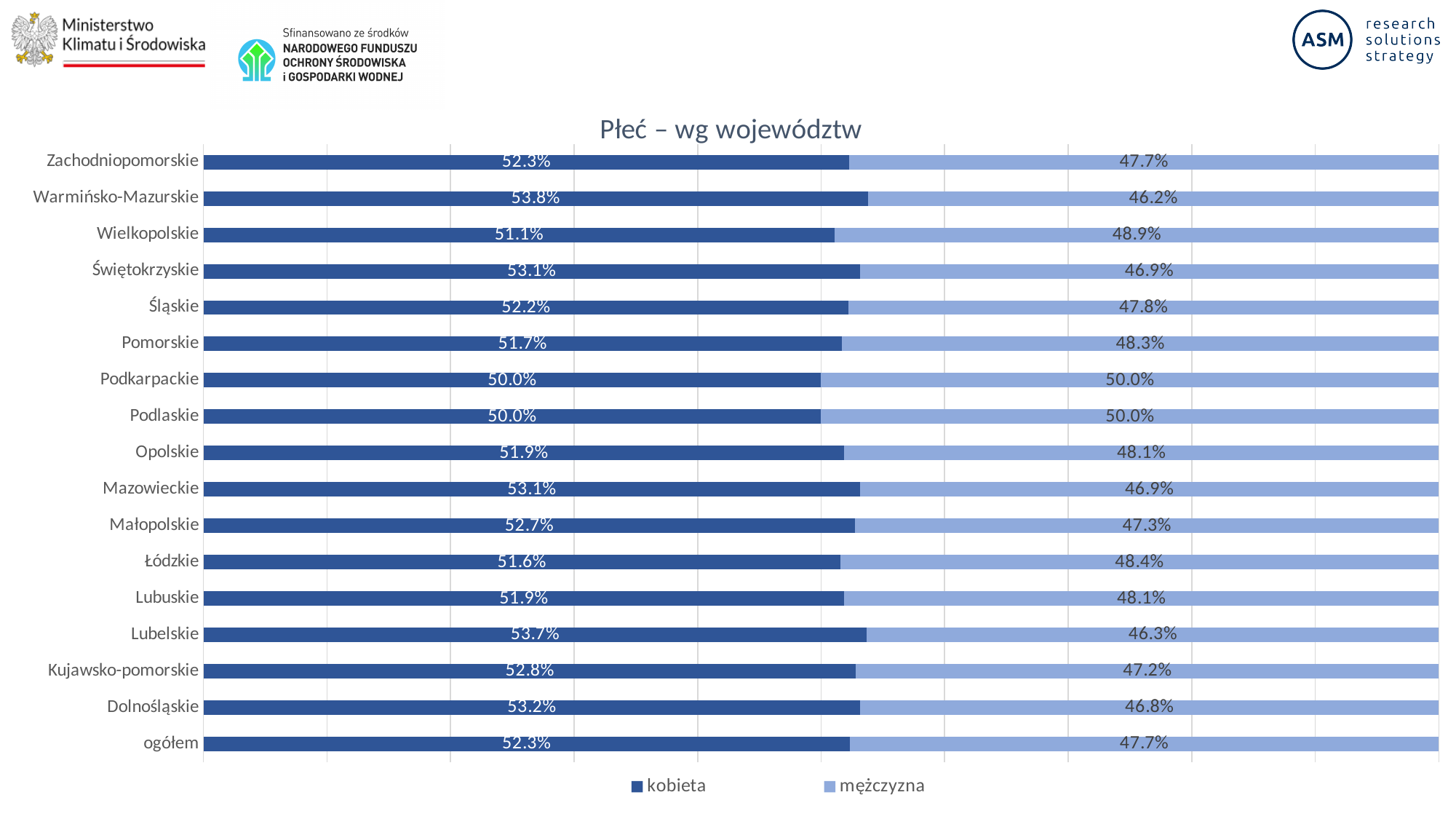
How many series does the legend list? 2 How many categories are shown on the chart? 17 What is the total of the stacked bar for Podkarpackie? 100.0% What is the value for kobieta in the ogółem row? 52.3% What is the difference between the kobieta and mężczyzna values in Dolnośląskie? 6.4% What is the value for mężczyzna in Lubelskie? 46.3% Which category has the lowest value for mężczyzna? Warmińsko-Mazurskie What is the value for kobieta in Wielkopolskie? 51.1% Which category has the highest value for kobieta? Warmińsko-Mazurskie What kind of chart is shown on the slide? Stacked bar chart What is the title of the chart? Płeć – wg województw Which is larger: the kobieta value for Mazowieckie or the kobieta value for Pomorskie? Mazowieckie